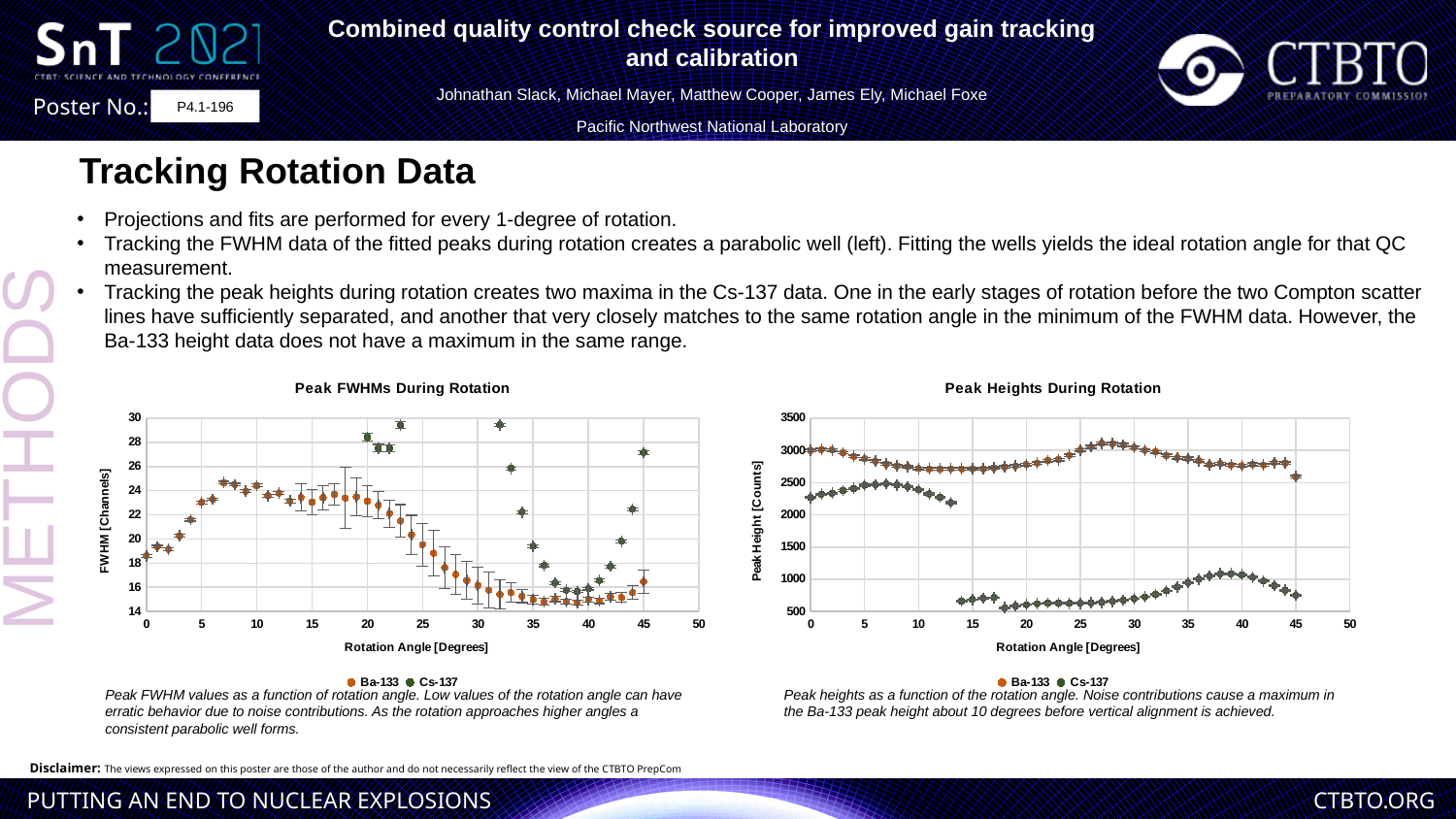
What kind of chart is the 'Peak FWHMs During Rotation' chart on the left? Scatter plot In the 'Peak FWHMs During Rotation' chart, is the Ba-133 value at 0 degrees greater or less than 20? less In the 'Peak Heights During Rotation' chart, do the Cs-137 values rise or fall as the rotation angle goes from 38 to 45 degrees? fall In the 'Peak FWHMs During Rotation' chart, is the Cs-137 value at 45 degrees greater or less than 26? greater What is the y-axis title of the 'Peak Heights During Rotation' chart? Peak Height [Counts] In the 'Peak FWHMs During Rotation' chart, do the Ba-133 values rise or fall as the rotation angle goes from 10 to 35 degrees? fall How many series does the legend of the 'Peak Heights During Rotation' chart list? 2 In the 'Peak FWHMs During Rotation' chart, which series has the higher FWHM at 45 degrees, Ba-133 or Cs-137? Cs-137 In the 'Peak Heights During Rotation' chart, is the Ba-133 value at 0 degrees greater or less than 2500? greater In the 'Peak Heights During Rotation' chart, which series has the higher peak height at 0 degrees, Ba-133 or Cs-137? Ba-133 What are the two series named in the legend of the 'Peak FWHMs During Rotation' chart? Ba-133 and Cs-137